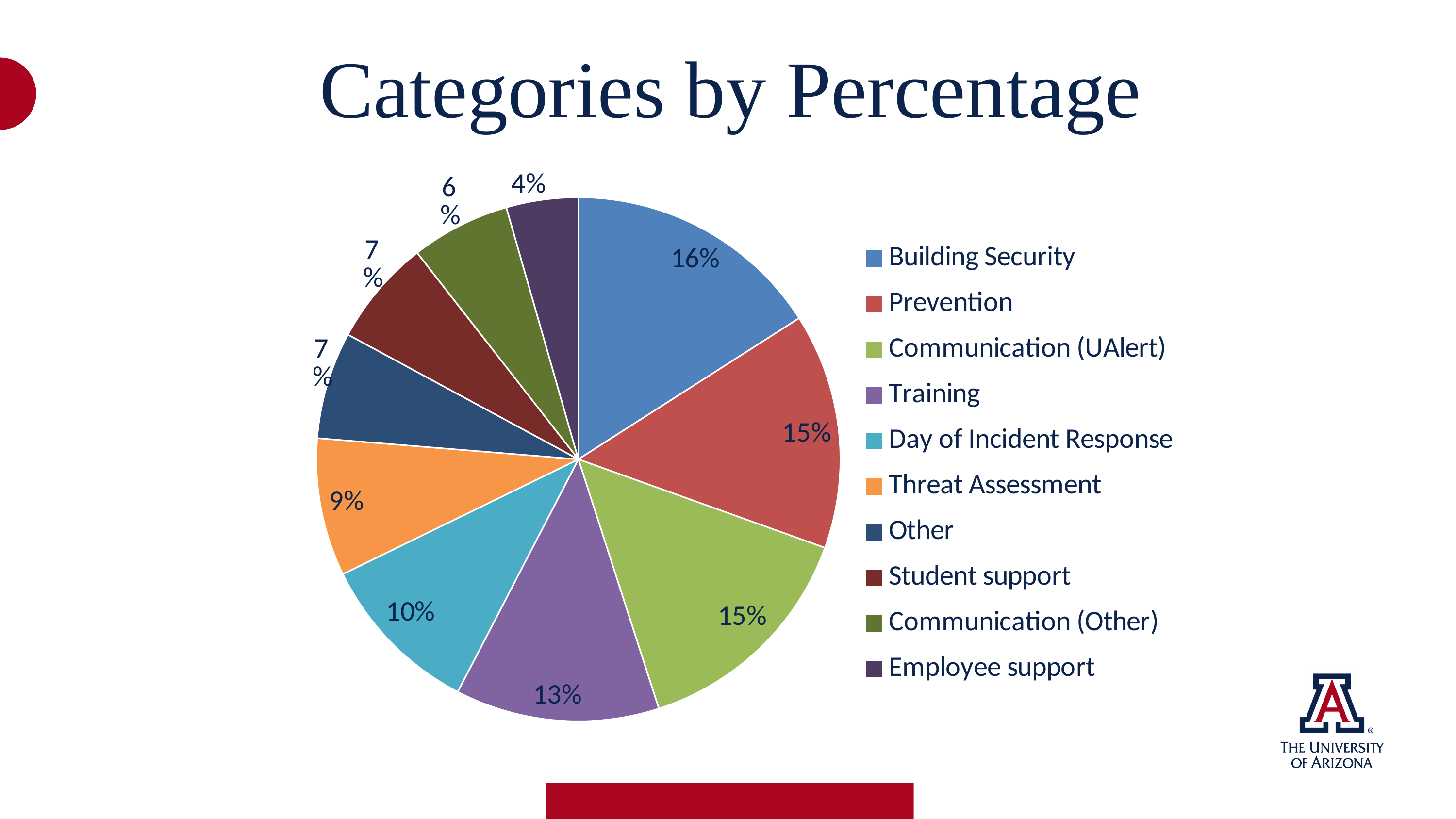
What type of chart is shown on the slide? Pie chart What is the difference in percentage points between Building Security and Threat Assessment? 7 Which category has the smallest share of the pie? Employee support What colour is the Threat Assessment slice? Orange What percentage does the Day of Incident Response slice represent? 10% What is the title of the chart? Categories by Percentage What percentage does the Employee support slice represent? 4% Which category has the largest share of the pie? Building Security What percentage does the Training slice represent? 13% What percentage does the Building Security slice represent? 16% How many categories are shown in the pie chart? 10 Which is larger, the Training slice or the Day of Incident Response slice? Training